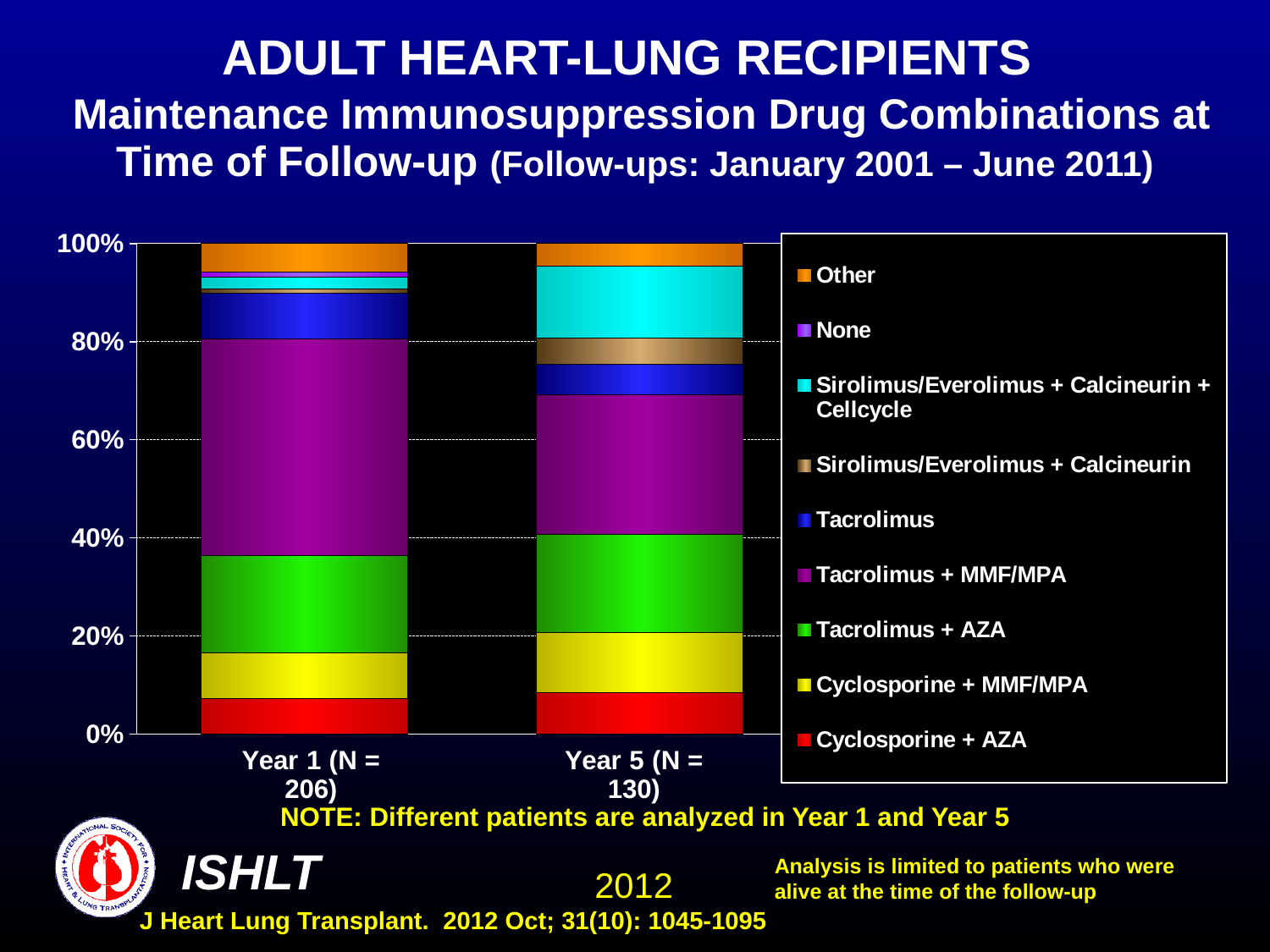
What is the N for the Year 1 bar? 206 What kind of chart is shown on the slide? stacked bar chart Is the share of Cyclosporine + AZA in Year 1 greater or less than 20%? less Which drug combination makes up the largest segment of the Year 1 bar? Tacrolimus + MMF/MPA Is the share of Sirolimus/Everolimus + Calcineurin + Cellcycle larger in Year 1 or in Year 5? Year 5 How many bars (follow-up time points) are plotted in the chart? 2 Is the share of Tacrolimus + MMF/MPA in Year 1 greater or less than 20%? greater Which legend entry is shown in orange at the top of the legend? Other What does each stacked bar total, as shown by the top of the bars on the y axis? 100% Is the share of Tacrolimus + MMF/MPA larger in Year 1 or in Year 5? Year 1 What is the N for the Year 5 bar? 130 How many drug combination series does the legend list? 9